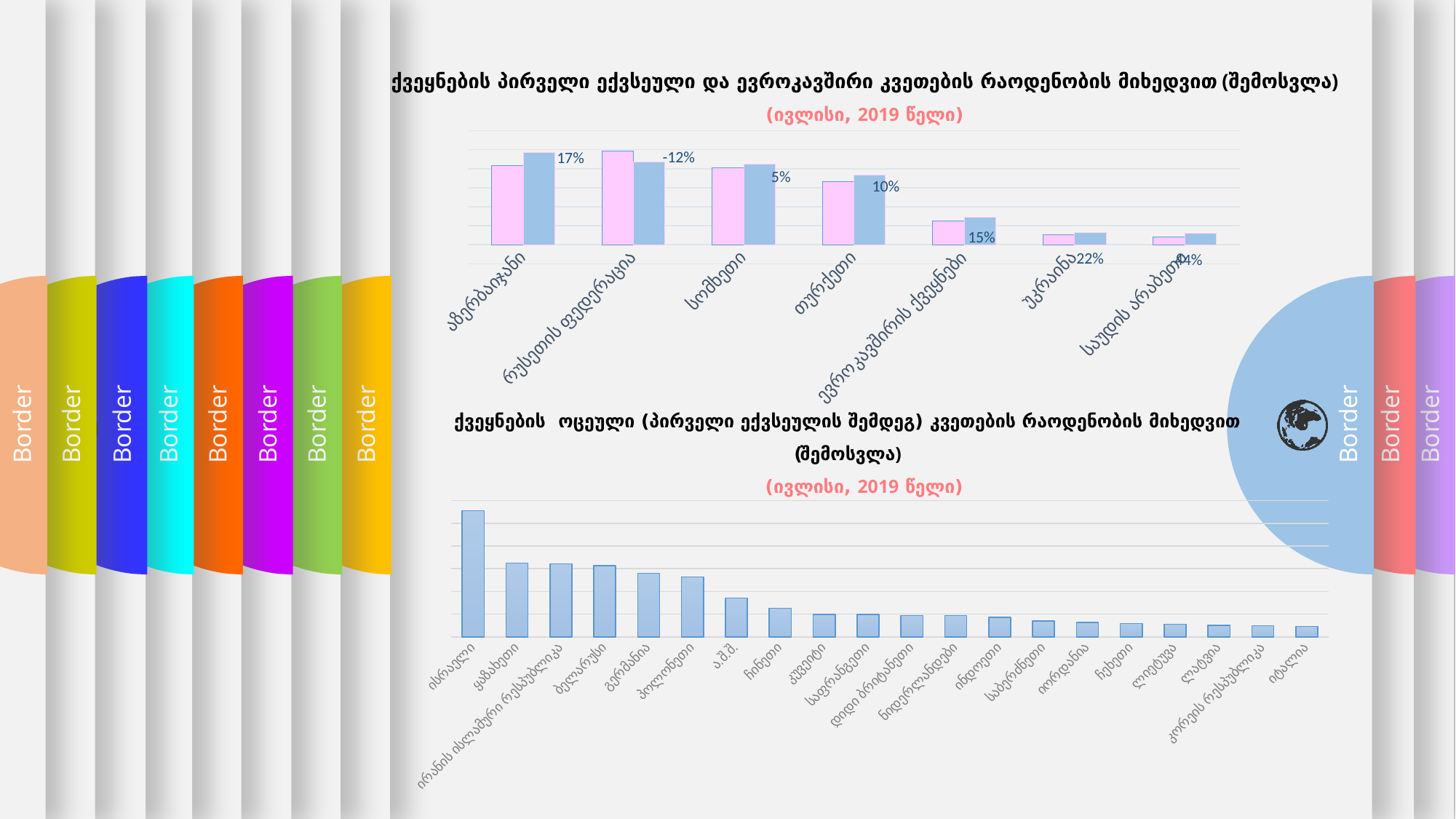
In the top chart, which category has the tallest blue bar? აზერბაიჯანი In the bottom chart, which has the larger value, ა.შ.შ. or ჩინეთი? ა.შ.შ. What kind of chart is the top chart on the slide? bar chart In the top chart, what percentage label is shown for აზერბაიჯანი? 17% In the bottom chart, which category has the highest value? ისრაელი How many categories are shown on the x axis of the top chart? 7 In the top chart, what percentage label is shown for უკრაინა? 22% In the top chart, what percentage label is shown for თურქეთი? 10% In the top chart, what percentage label is shown for რუსეთის ფედერაცია? -12% How many categories are shown on the x axis of the bottom chart? 20 In the top chart, what percentage label is shown for საუდის არაბეთი? 44% In the bottom chart, do the values generally rise or fall from left to right along the x axis? fall